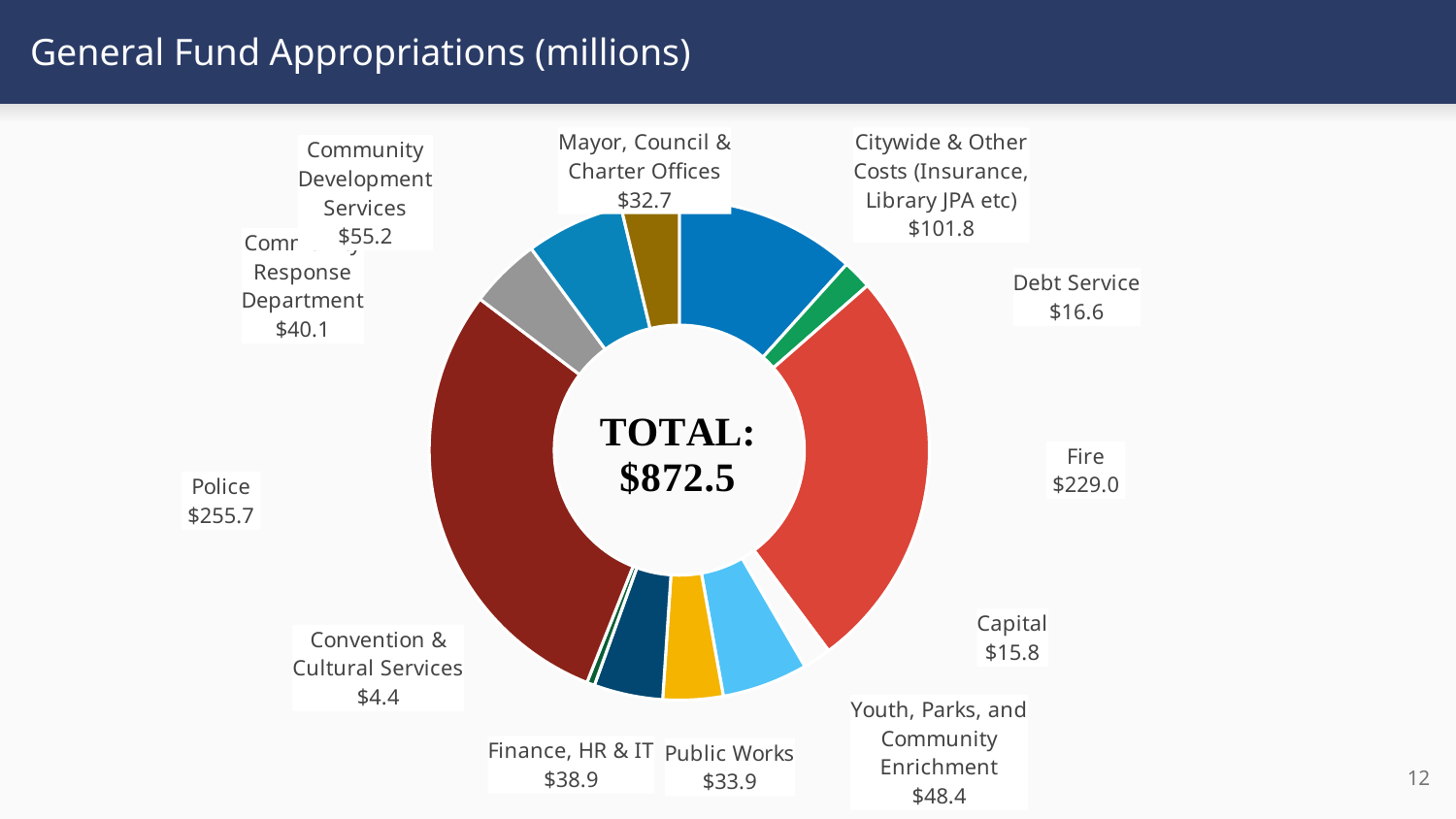
Which category has the largest appropriation? Police What is the difference between the Police and Fire appropriations? $26.7 What is the value for Citywide & Other Costs (Insurance, Library JPA etc)? $101.8 How many categories are shown in the chart? 12 What is the value for Fire? $229.0 What total is shown in the centre of the chart? $872.5 What is the title of the slide? General Fund Appropriations (millions) What is the value for Police? $255.7 Which is larger, Debt Service or Capital? Debt Service What kind of chart is shown on the slide? pie chart (donut) Which category has the smallest appropriation? Convention & Cultural Services What is the value for Youth, Parks, and Community Enrichment? $48.4